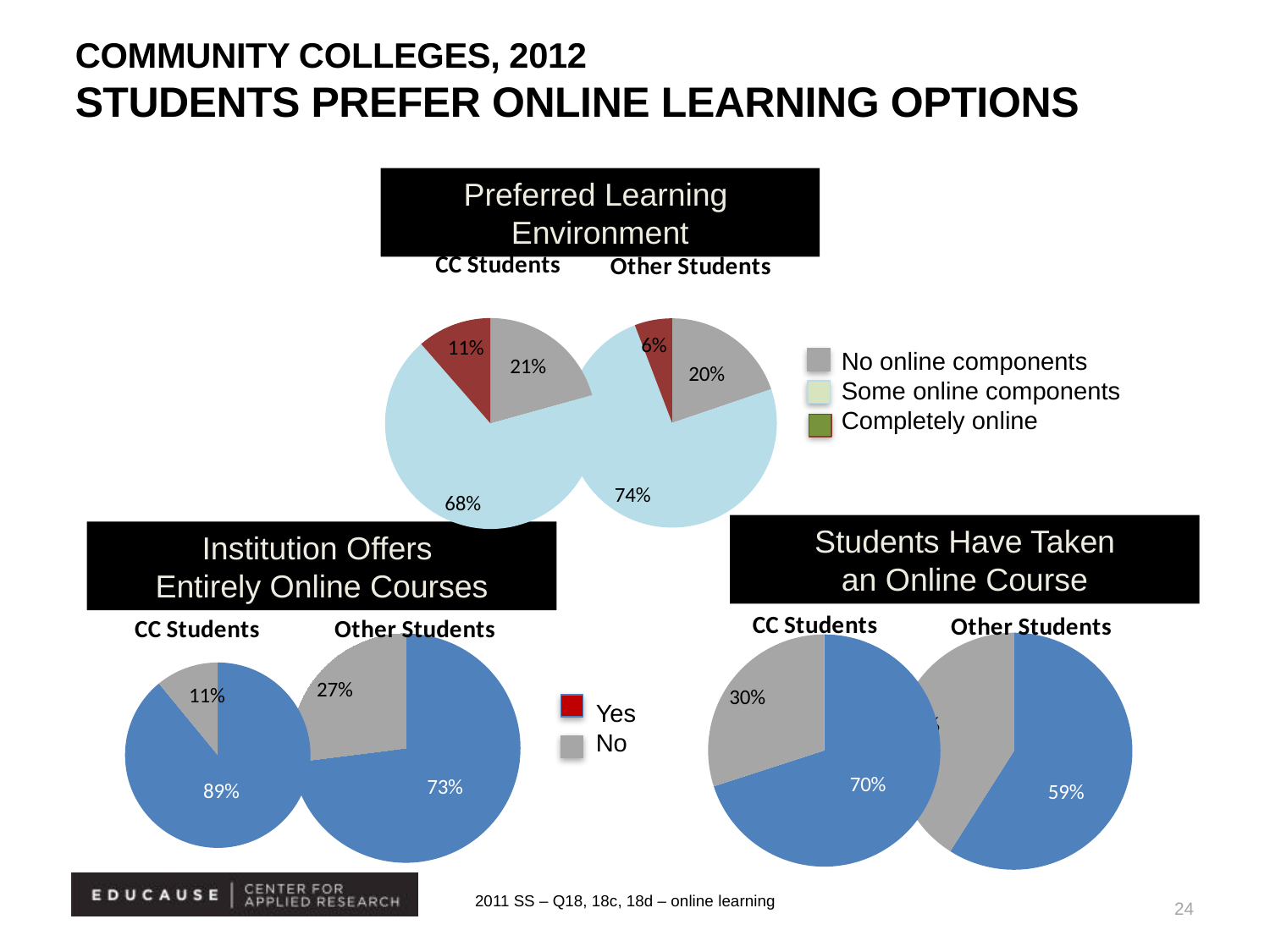
In the Preferred Learning Environment chart for CC Students, what percentage prefer no online components? 21% In the Preferred Learning Environment chart for CC Students, which category has the smallest share? Completely online In the Preferred Learning Environment chart for Other Students, what percentage prefer a completely online environment? 6% In the Students Have Taken an Online Course chart, which group has the larger Yes share, CC Students or Other Students? CC Students In the Institution Offers Entirely Online Courses chart for Other Students, what percentage answered Yes? 73% In the Preferred Learning Environment charts, how much higher is the 'Some online components' share for Other Students than for CC Students? 6 percentage points What type of chart is used for the Institution Offers Entirely Online Courses data? Pie chart In the Students Have Taken an Online Course chart for CC Students, what is the difference between the Yes and No shares? 40 percentage points How many entries does the legend for the Preferred Learning Environment chart list? 3 In the Preferred Learning Environment chart for Other Students, which category has the largest share? Some online components In the Institution Offers Entirely Online Courses chart for CC Students, what percentage answered No? 11% In the Preferred Learning Environment chart for CC Students, what percentage prefer some online components? 68%